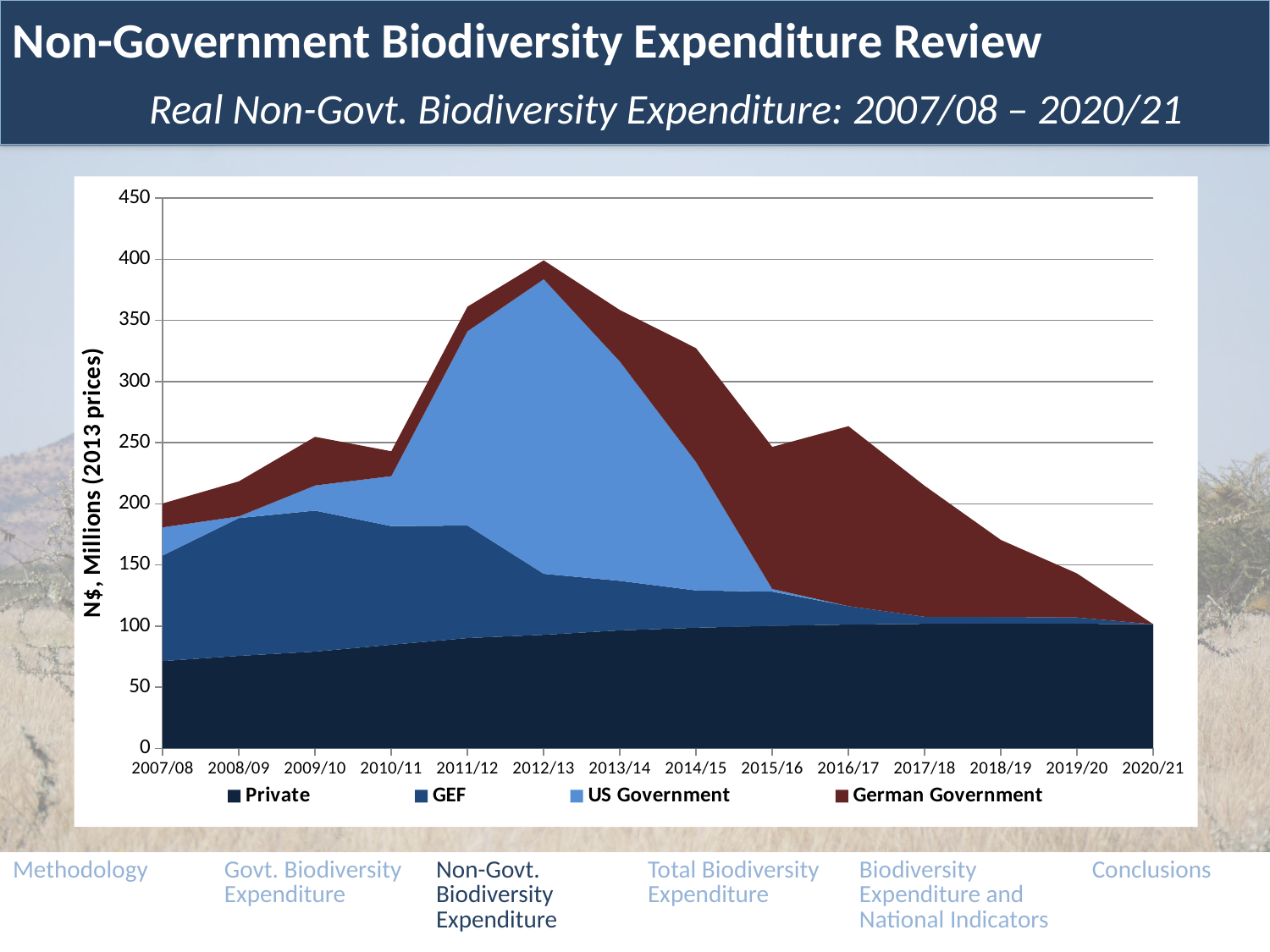
Does the total expenditure rise or fall from 2012/13 to 2020/21? Fall In which year is the total non-government biodiversity expenditure lowest? 2020/21 Is the total expenditure in 2007/08 greater or less than 250? less What kind of chart is shown on the slide? Stacked area chart How many fiscal years are shown along the x axis? 14 Is the total expenditure in 2012/13 greater or less than 350? greater How many series does the legend list? 4 What is the label on the y axis? N$, Millions (2013 prices) In which year does the total non-government biodiversity expenditure reach its highest point? 2012/13 Is the Private expenditure in 2007/08 greater or less than 100? less Which year has the larger total expenditure, 2012/13 or 2007/08? 2012/13